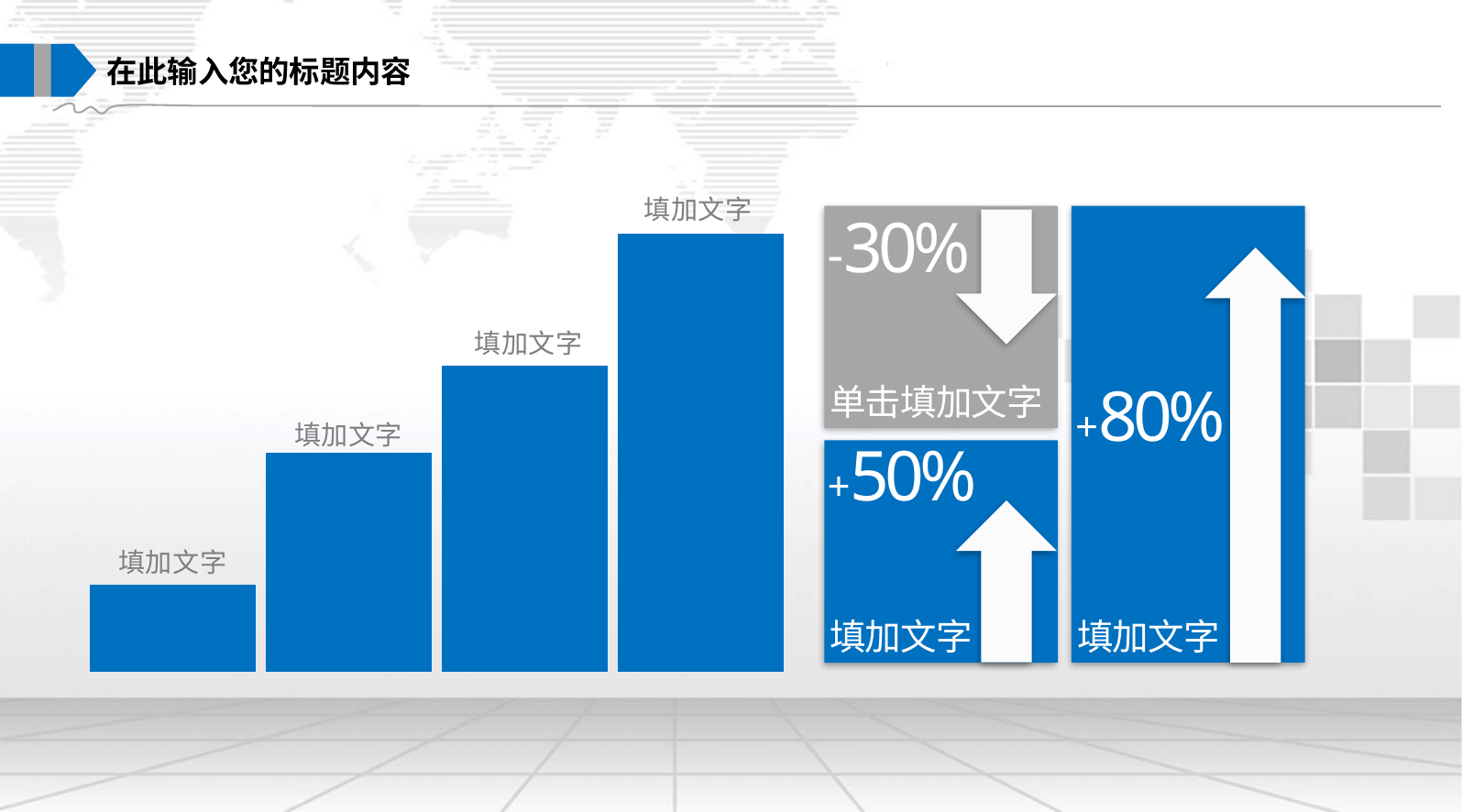
How many bars does the bar chart have? 4 What colour are the bars in the chart? blue Which bar in the chart is the shortest, counting from the left? the first (leftmost) bar What label is printed above each bar in the chart? 填加文字 Do the bars in the chart rise or fall from left to right? rise What kind of chart is shown on the left of the slide? bar chart Is the second bar from the left taller or shorter than the third bar from the left? shorter Which bar in the chart is the tallest, counting from the left? the fourth (rightmost) bar Is the third bar from the left taller or shorter than the first bar from the left? taller